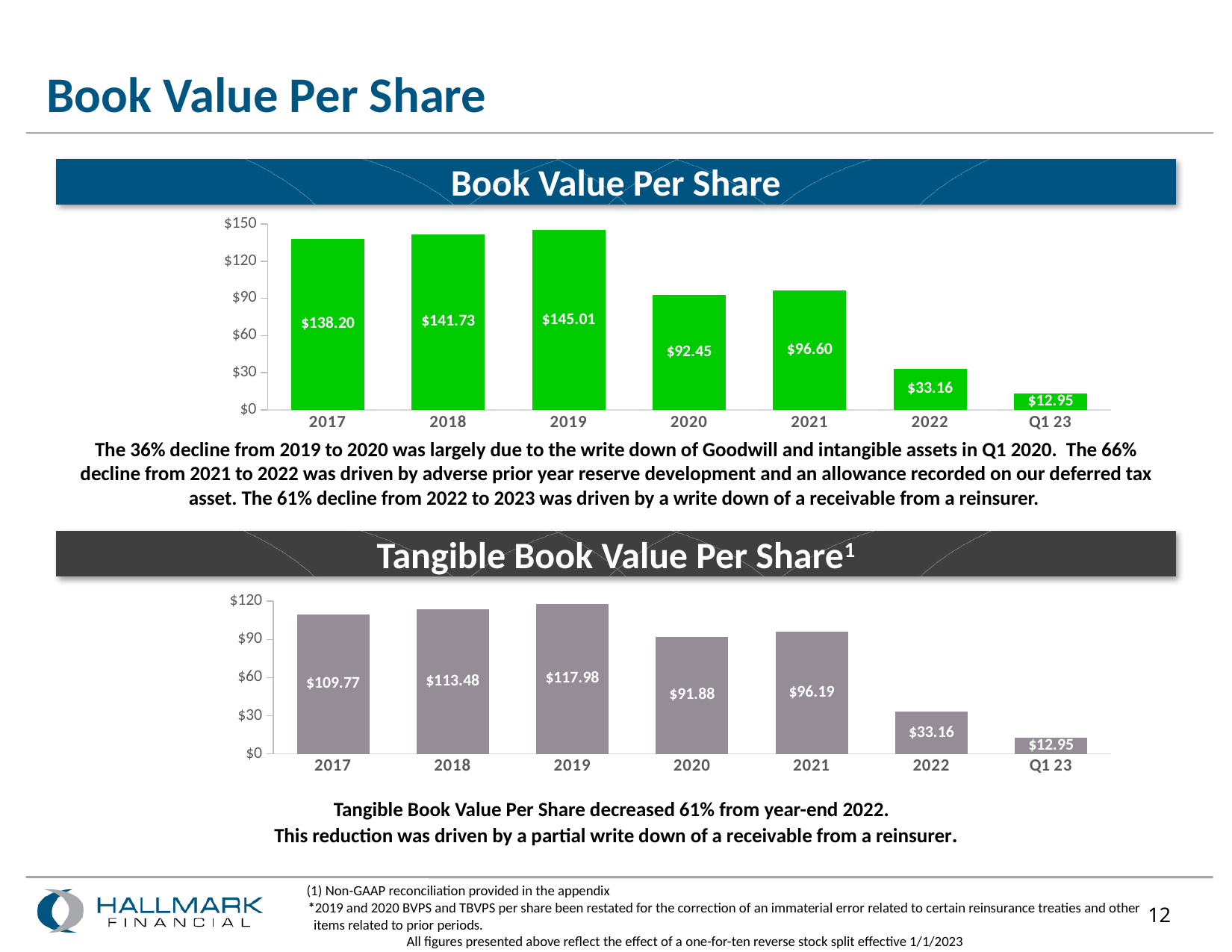
In the Book Value Per Share chart, which year has the highest value? 2019 In the Tangible Book Value Per Share chart, is the value for 2020 larger or the value for 2021? 2021 In the Tangible Book Value Per Share chart, which year has the highest value? 2019 In the Book Value Per Share chart, which period has the lowest value? Q1 23 In the Book Value Per Share chart, what is the value for 2019? $145.01 What is the value for Q1 23 in the Tangible Book Value Per Share chart? $12.95 In the Tangible Book Value Per Share chart, what is the difference between the 2017 and 2019 values? $8.21 In the Book Value Per Share chart, do the values generally rise or fall from 2019 to Q1 23? Fall In the Book Value Per Share chart, what is the difference between the 2021 and 2022 values? $63.44 In the Tangible Book Value Per Share chart, what is the value for 2018? $113.48 What type of chart is the Tangible Book Value Per Share chart? Bar chart In the Book Value Per Share chart, how many periods are plotted? 7